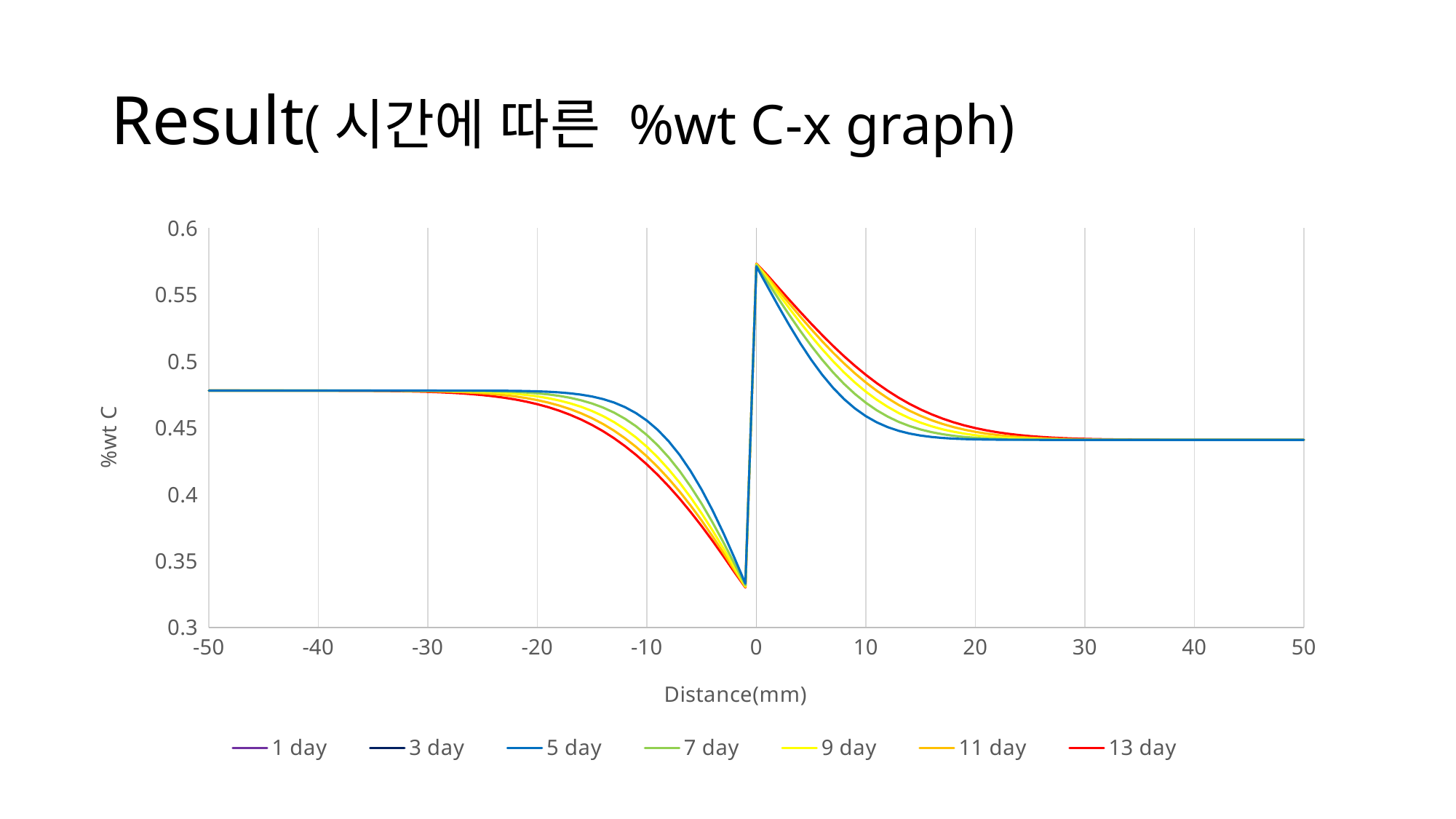
What is the title of the y axis? %wt C What is the title of the x axis? Distance(mm) Is the value of the 13 day series at a distance of -50 mm greater or less than 0.45? greater What kind of chart is shown on the slide? line chart At a distance of -10 mm, which series has the larger value, 5 day or 13 day? 5 day Is the lowest value of the 13 day series just before 0 mm greater or less than 0.35? less Do the values of the 13 day series rise or fall as distance increases from 0 mm to 20 mm? fall Do the values of the 13 day series rise or fall as distance increases from -30 mm to -5 mm? fall How many series does the legend list? 7 Is the value of the 13 day series at a distance of 50 mm greater or less than 0.45? less At a distance of 10 mm, which series has the larger value, 5 day or 13 day? 13 day